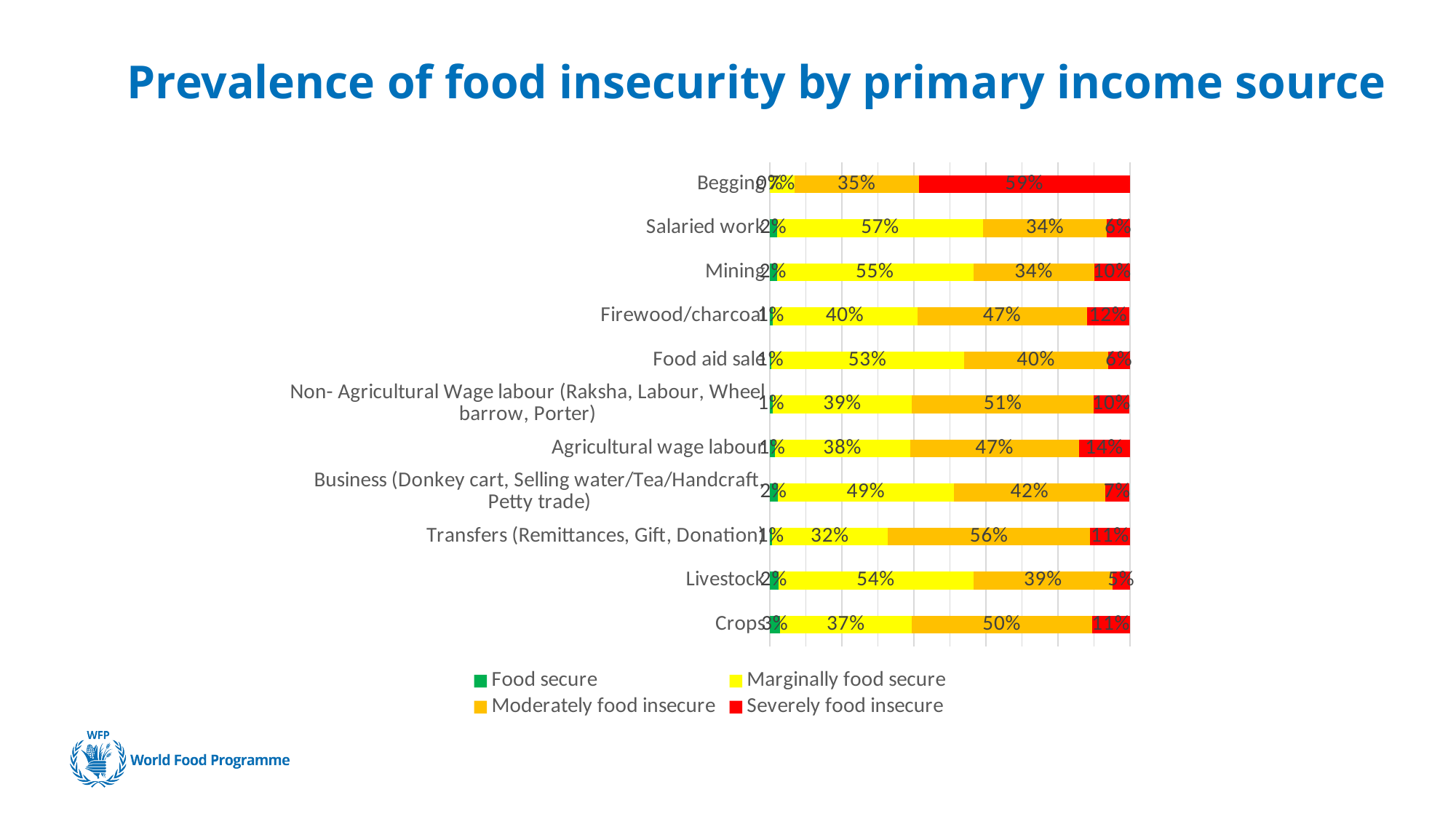
How many series does the legend list? 4 What is the Severely food insecure share for Begging? 59% What is the Food secure share for Crops? 3% What kind of chart is shown on the slide? Bar chart What is the difference between the Severely food insecure share for Begging and for Transfers (Remittances, Gift, Donation)? 48 percentage points Which income source has the highest Severely food insecure share? Begging Which has a larger Marginally food secure share, Mining or Crops? Mining What is the Moderately food insecure share for Firewood/charcoal? 47% What is the Marginally food secure share for Salaried work? 57% How many income source categories are plotted in the chart? 11 Which income source has the highest Moderately food insecure share? Transfers (Remittances, Gift, Donation) What is the Moderately food insecure share for Transfers (Remittances, Gift, Donation)? 56%